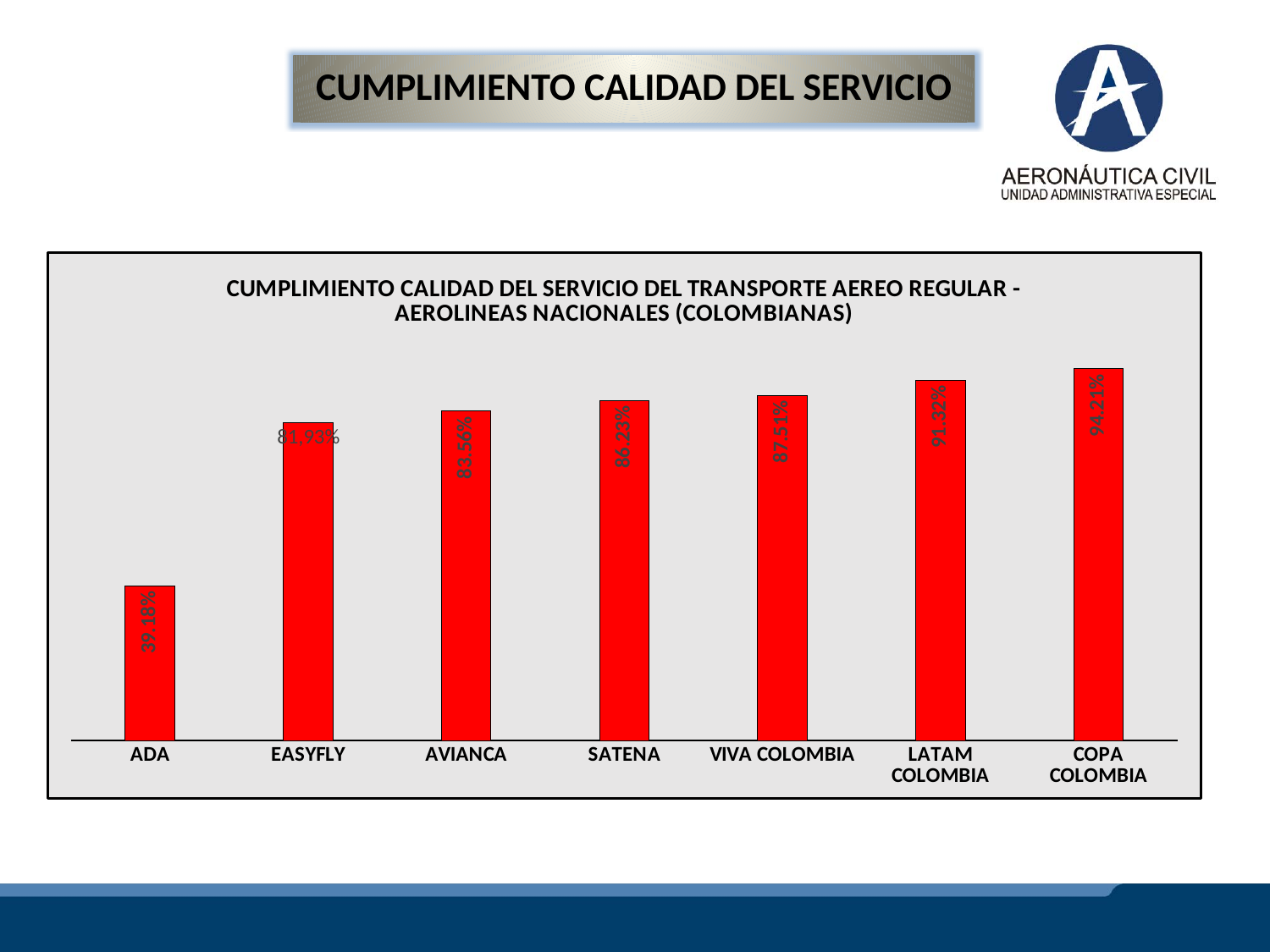
What kind of chart is shown on the slide? Bar chart Do the values rise or fall from left to right across the airlines? Rise Which airline has the highest value? COPA COLOMBIA Which is larger, the value for EASYFLY or the value for AVIANCA? AVIANCA Which airline has the lowest value? ADA What is the value for VIVA COLOMBIA? 87,51% What is the value for COPA COLOMBIA? 94,21% What is the difference between the values for COPA COLOMBIA and ADA? 55,03 percentage points What is the value for SATENA? 86,23% What is the difference between the values for LATAM COLOMBIA and VIVA COLOMBIA? 3,81 percentage points What is the value for ADA? 39,18% How many airlines are shown in the chart? 7